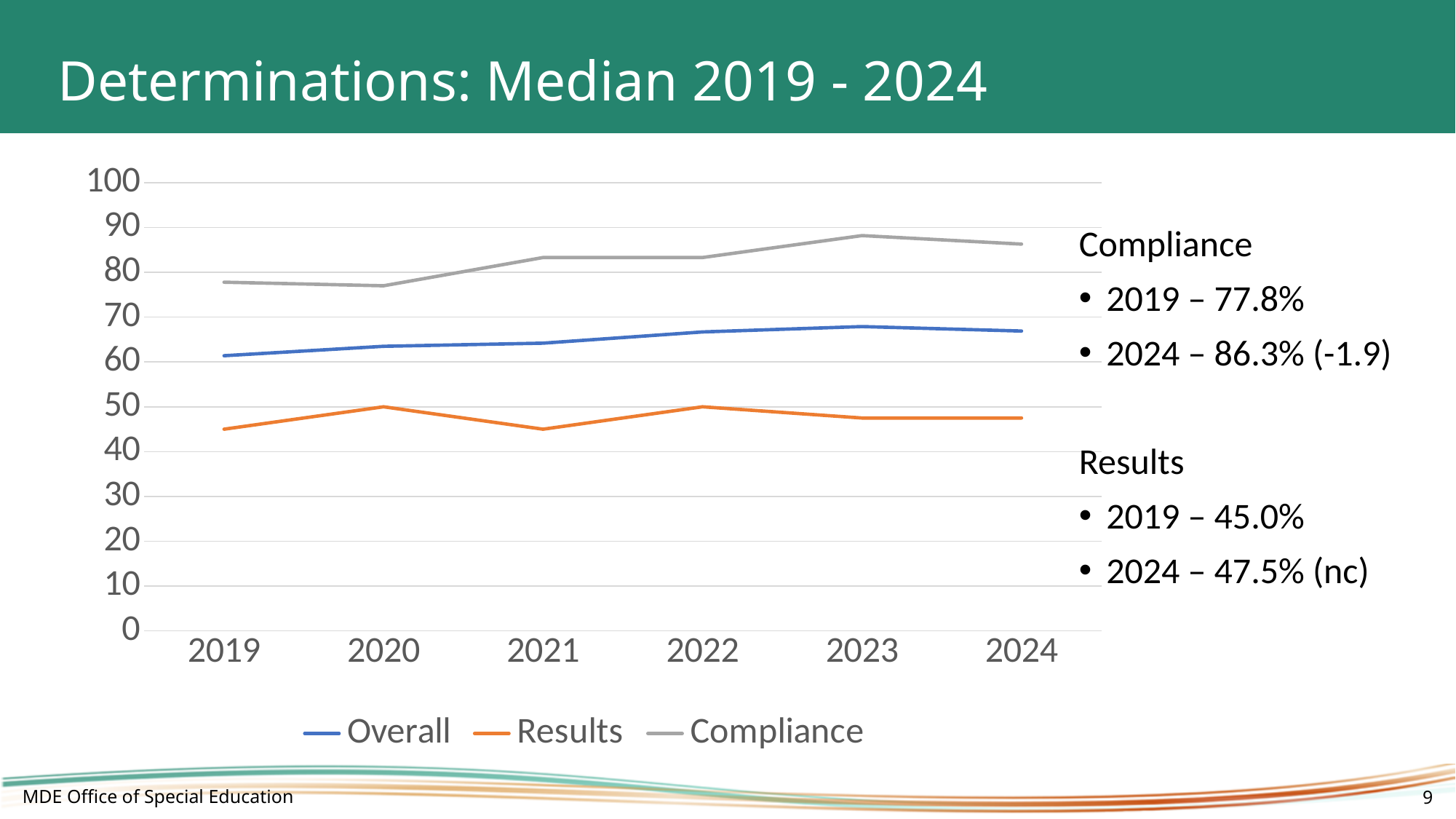
Is the Overall value for 2023 greater or less than 70? less What kind of chart is shown on the slide? line chart What is the Compliance median value for 2024? 86.3% How many years are plotted along the x axis? 6 What is the Results median value for 2024? 47.5% Which colour is used for the Results line? orange By how many percentage points did the Compliance median change from 2019 to 2024? 8.5 What is the Results median value for 2019? 45.0% In 2022, which is larger, the Compliance value or the Results value? Compliance How many series does the legend list? 3 In which year does the Compliance line reach its highest point? 2023 What is the Compliance median value for 2019? 77.8%